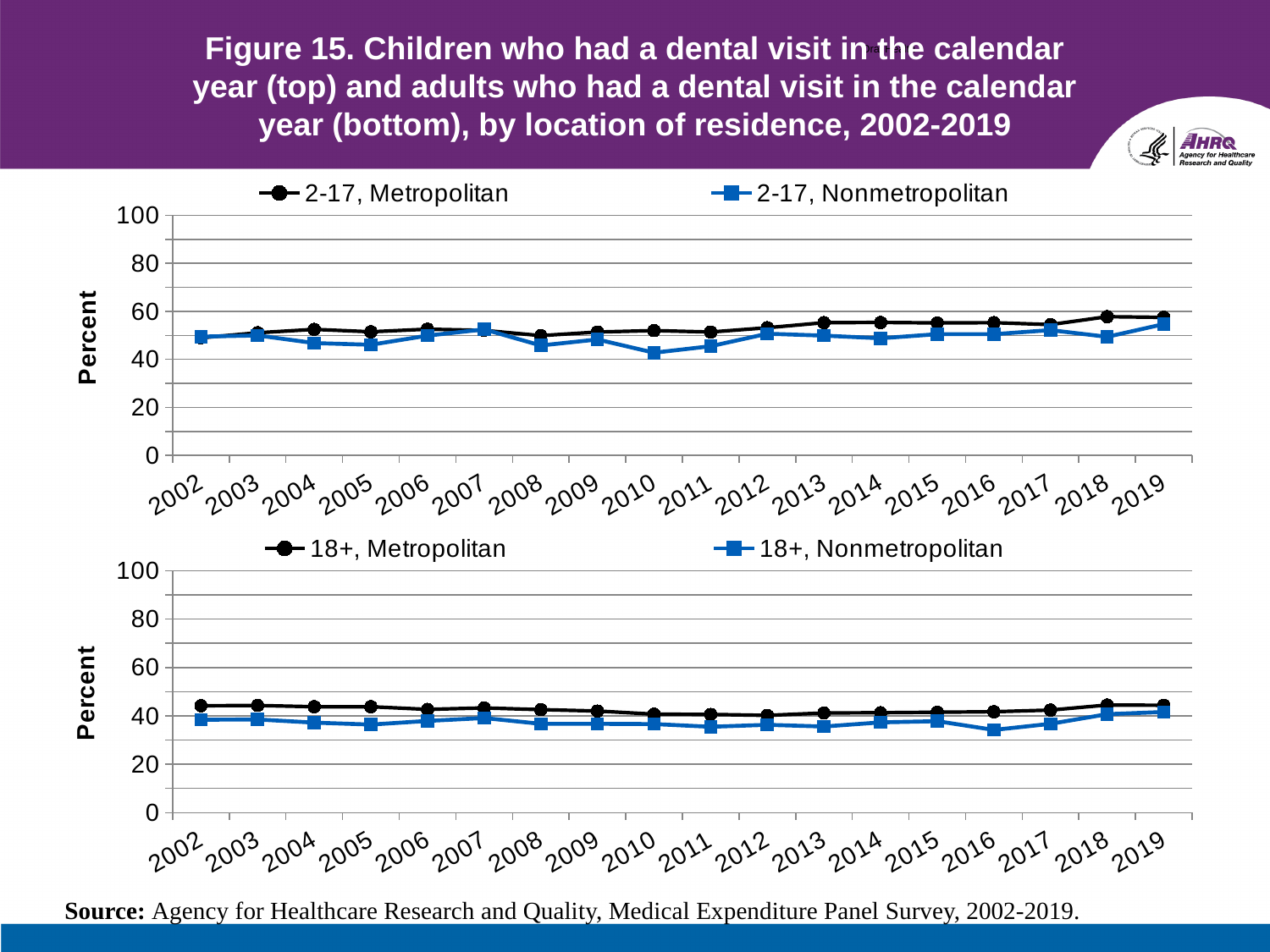
In the top chart, does the value for 2-17, Nonmetropolitan rise or fall from 2010 to 2019? rise In the bottom chart, which series has the higher value in 2016, 18+, Metropolitan or 18+, Nonmetropolitan? 18+, Metropolitan In the top chart, is the value for 2-17, Metropolitan in 2019 greater or less than 40? greater How many series does the legend of the top chart list? 2 How many years are plotted along the x axis of the bottom chart? 18 In the bottom chart, is the value for 18+, Nonmetropolitan in 2016 greater or less than 40? less In the bottom chart, is the value for 18+, Metropolitan in 2018 greater or less than 20? greater What type of chart is the top chart on the slide? Line chart In the top chart, in which year is the value for 2-17, Nonmetropolitan lowest? 2010 What is the label on the y axis of the bottom chart? Percent In the top chart, which series has the higher value in 2010, 2-17, Metropolitan or 2-17, Nonmetropolitan? 2-17, Metropolitan